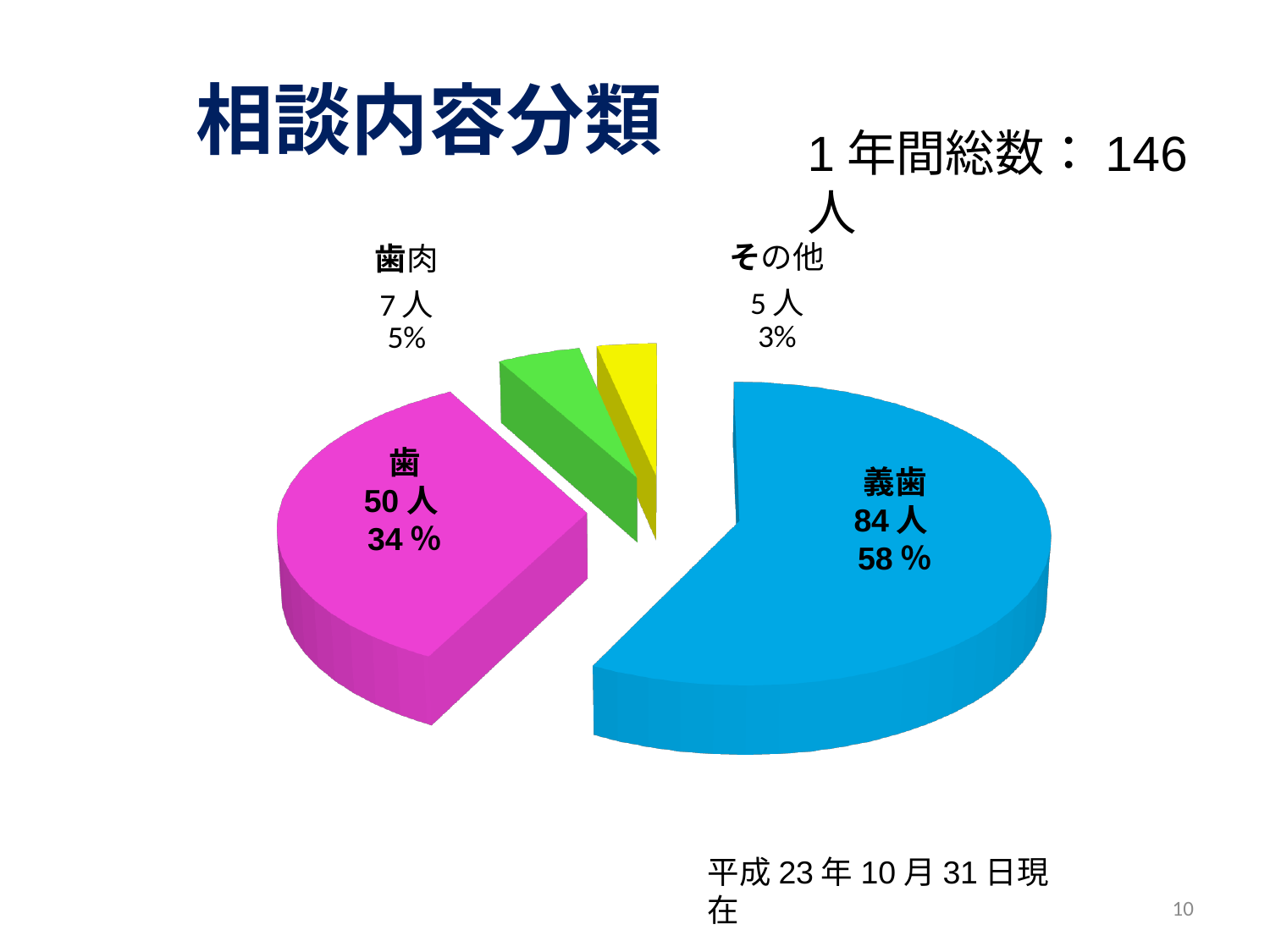
Which category has more people, 歯肉 or その他? 歯肉 What colour is the 義歯 slice? blue How many people are in the 歯肉 category? 7 人 How many slices does the pie chart have? 4 Which category has the smallest slice? その他 What is the total number of consultations for the year shown on the slide? 146 人 What is the difference in number of people between 義歯 and 歯? 34 人 What kind of chart is shown on the slide? pie chart What percentage share does the 歯 slice have? 34 % What percentage share does the その他 slice have? 3% Which category has the largest slice? 義歯 How many people are in the 義歯 category? 84 人